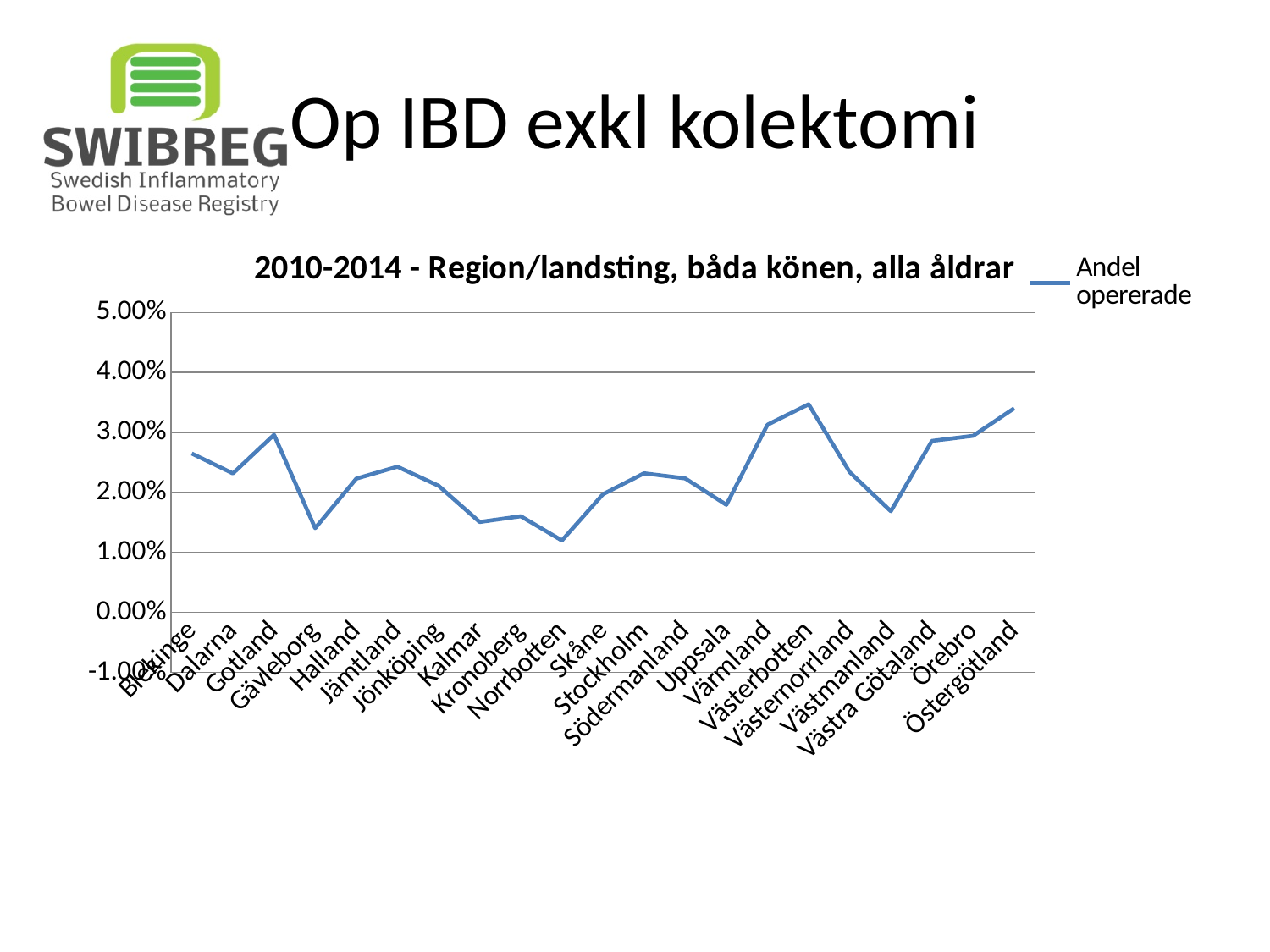
What kind of chart is shown on the slide? Line chart Which has the larger value, Gotland or Gävleborg? Gotland How many regions are plotted along the x axis of the chart? 21 Which region has the lowest value in the chart? Norrbotten How many series does the chart legend list? 1 Which region has the highest value in the chart? Västerbotten Is the value for Kronoberg greater or less than 2.00%? less Is the value for Västerbotten greater or less than 3.00%? greater Is the value for Gävleborg greater or less than 2.00%? less What is the name of the series shown in the chart legend? Andel opererade What is the title of the chart? 2010-2014 - Region/landsting, båda könen, alla åldrar